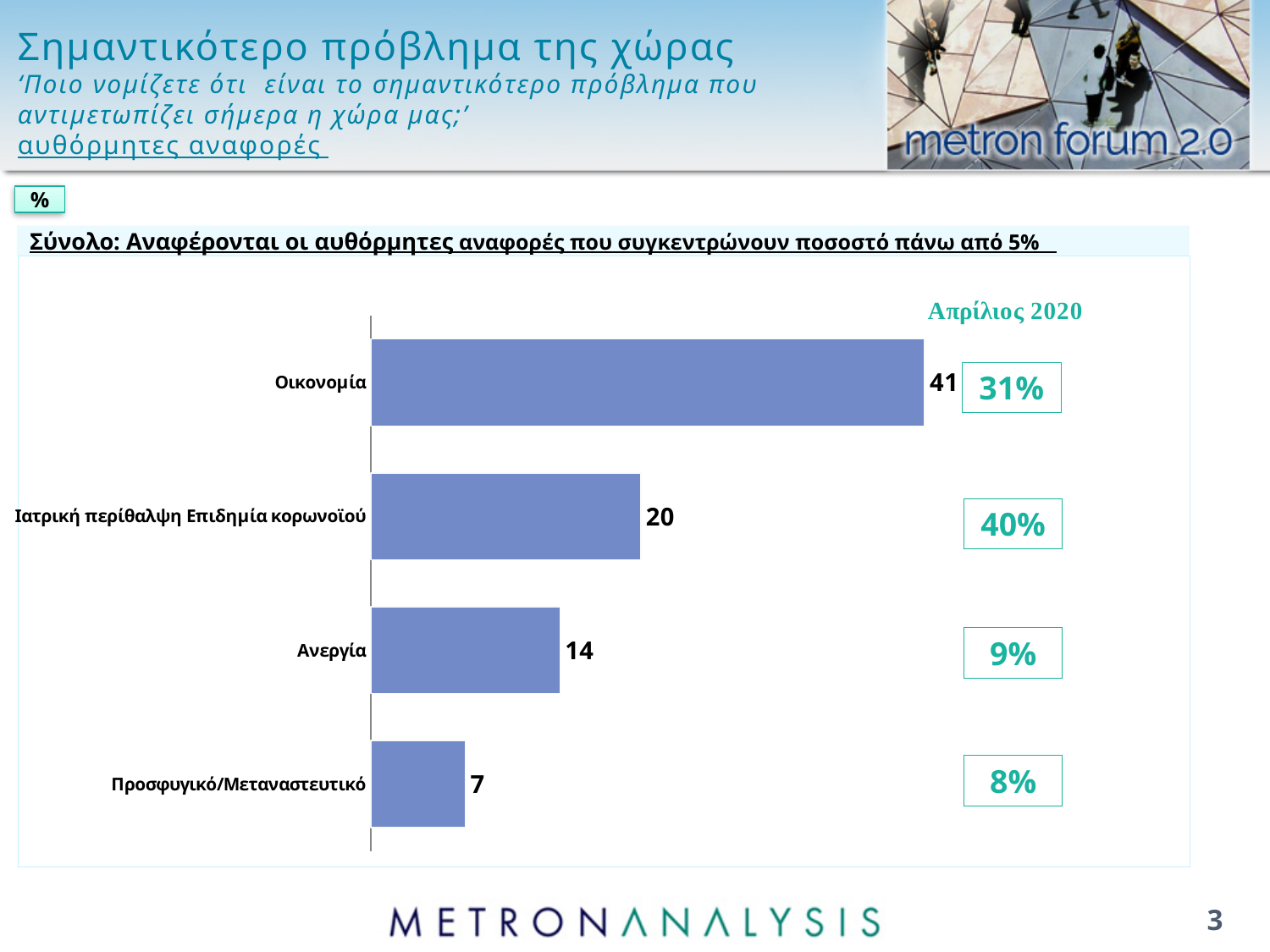
What is the difference between the values for Ανεργία and Προσφυγικό/Μεταναστευτικό? 7 What is the difference between the values for Οικονομία and Ιατρική περίθαλψη Επιδημία κορωνοϊού? 21 What value is shown for Προσφυγικό/Μεταναστευτικό in the bar chart? 7 Which is larger, the value for Ανεργία or the value for Ιατρική περίθαλψη Επιδημία κορωνοϊού? Ιατρική περίθαλψη Επιδημία κορωνοϊού How many categories are shown in the bar chart? 4 What value is shown for Ανεργία in the bar chart? 14 What Απρίλιος 2020 value is shown in the box next to the Ανεργία bar? 9% What value is shown for Οικονομία in the bar chart? 41 Which category has the lowest value in the bar chart? Προσφυγικό/Μεταναστευτικό What kind of chart is shown on the slide? Bar chart What value is shown for Ιατρική περίθαλψη Επιδημία κορωνοϊού in the bar chart? 20 Which category has the highest value in the bar chart? Οικονομία